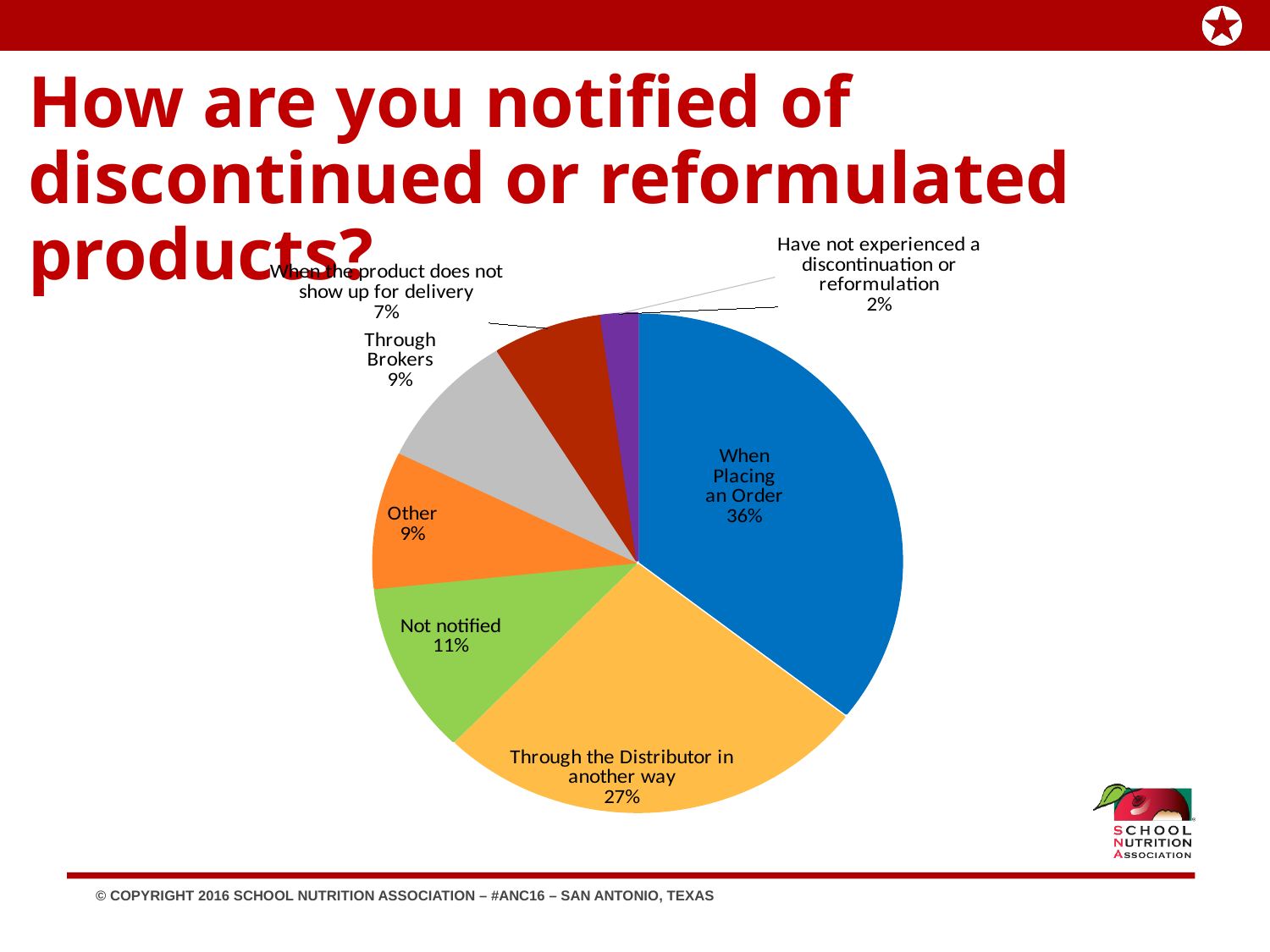
What is the difference in percentage points between 'When Placing an Order' and 'Through the Distributor in another way'? 9 Which notification method has the largest share of the pie? When Placing an Order What kind of chart is shown on the slide? Pie chart What percentage of respondents find out when the product does not show up for delivery? 7% What percentage of respondents are not notified? 11% What percentage of respondents have not experienced a discontinuation or reformulation? 2% What percentage of respondents are notified through the distributor in another way? 27% Which category has the smallest share of the pie? Have not experienced a discontinuation or reformulation What percentage of respondents are notified through brokers? 9% What share of respondents are notified when placing an order? 36% Which is larger: the share for 'Not notified' or the share for 'Other'? Not notified How many slices does the pie chart have? 7